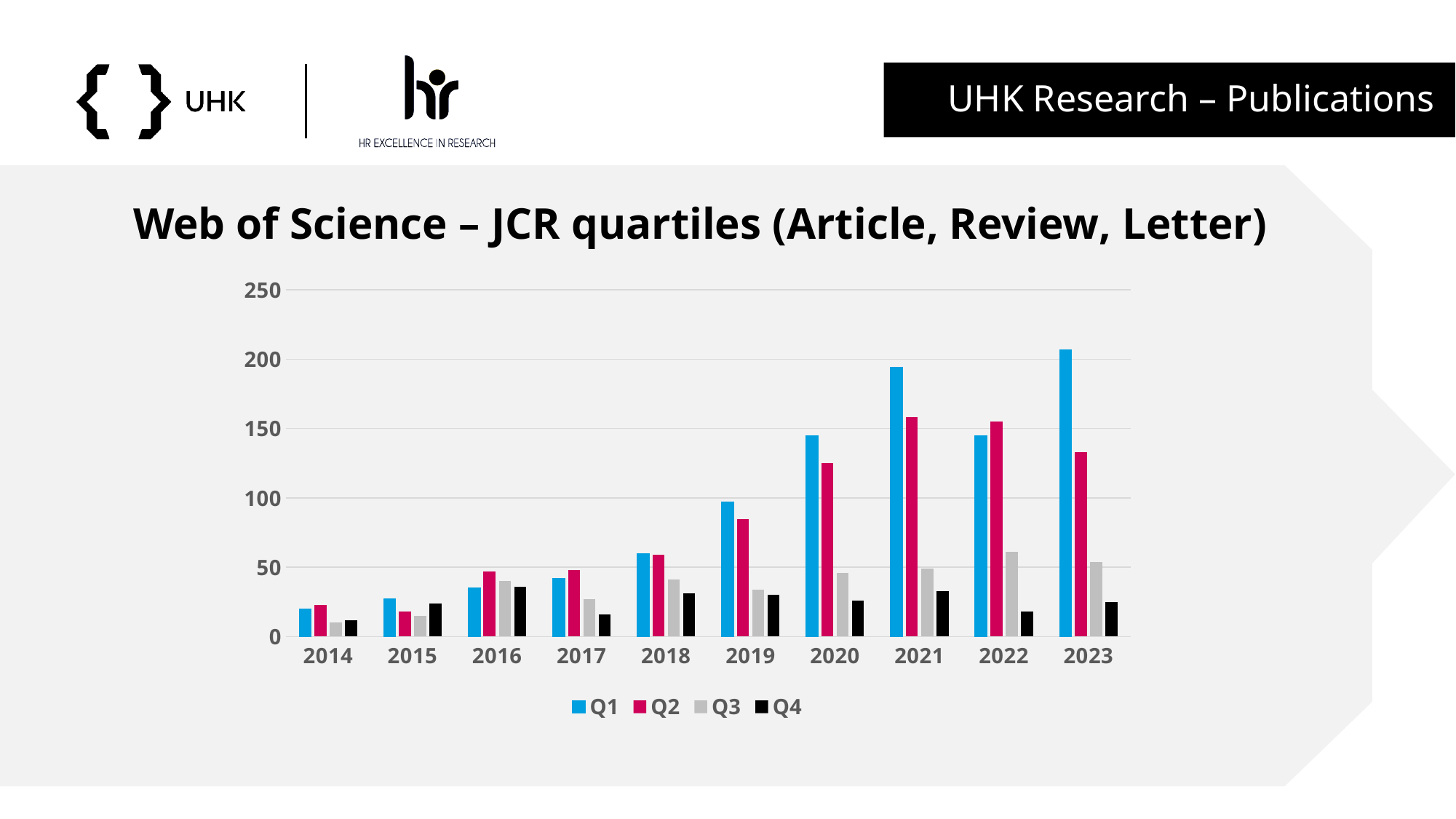
How many series does the legend list? 4 Do the Q1 values rise or fall from 2014 to 2021? rise What colour represents Q1 in the legend? blue In 2022, which is larger, Q1 or Q2? Q2 In which year is the Q1 value highest? 2023 Is the Q2 value for 2021 greater or less than 150? greater What kind of chart is shown on the slide? bar chart In 2020, which is larger, Q1 or Q2? Q1 How many years are shown on the x axis? 10 Is the Q3 value for 2022 greater or less than 50? greater Is the Q1 value for 2023 greater or less than 200? greater In which year is the Q4 value lowest? 2014